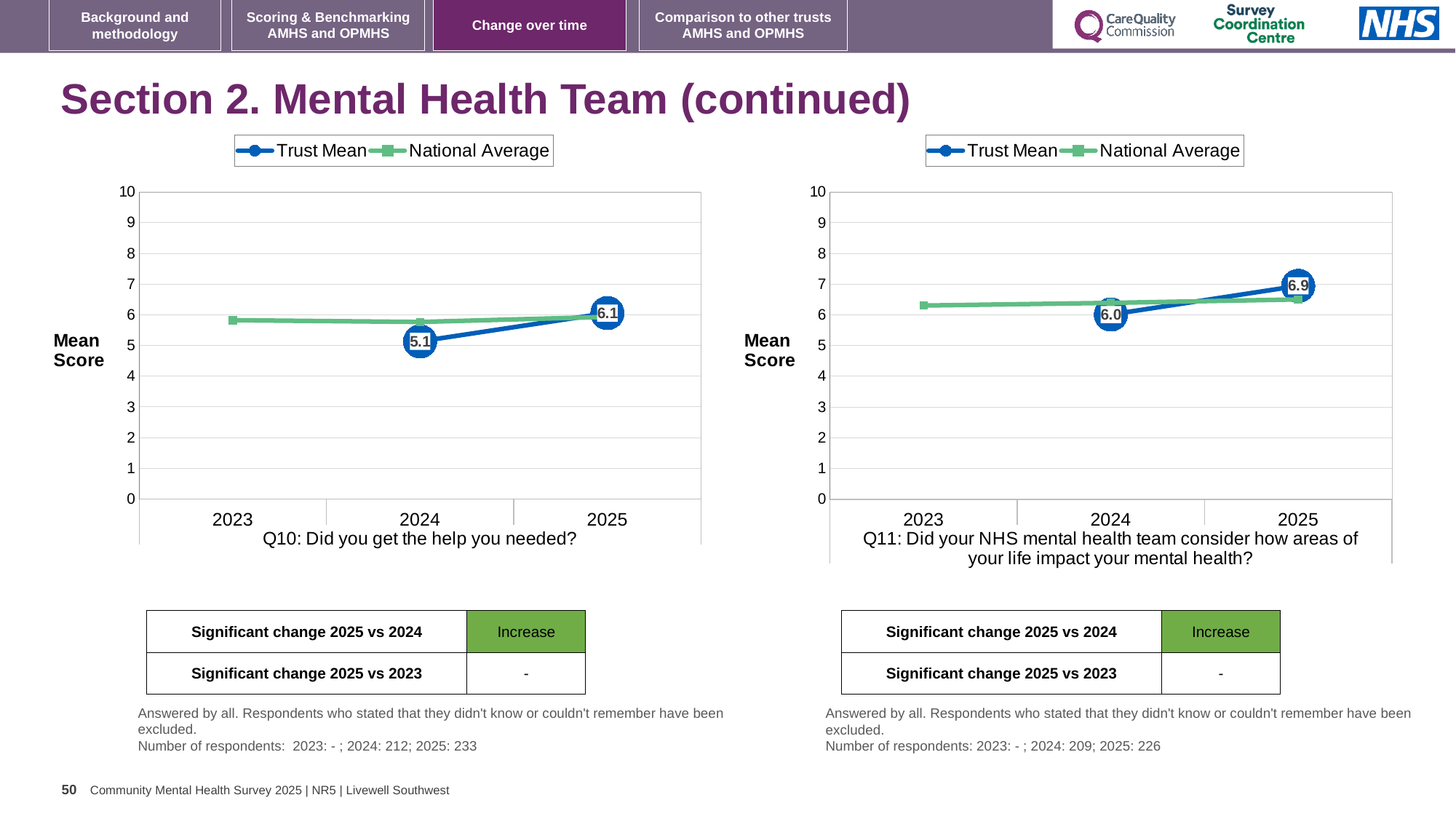
In the Q11 chart, what is the difference between the Trust Mean in 2025 and in 2024? 0.9 In the Q10 chart, what is the Trust Mean score for 2024? 5.1 In the Q11 chart, what is the Trust Mean score for 2024? 6.0 What kind of chart is the Q10 chart? line chart How many years are shown on the x axis of the Q10 chart? 3 In the Q11 chart, does the Trust Mean rise or fall from 2024 to 2025? rise How many series does the legend of the Q11 chart list? 2 In the Q11 chart, what is the Trust Mean score for 2025? 6.9 In the Q10 chart, which is larger in 2025: the Trust Mean or the National Average? Trust Mean In the Q11 chart, is the National Average for 2023 greater or less than 6? greater In the Q10 chart, what is the Trust Mean score for 2025? 6.1 In the Q10 chart, by how much did the Trust Mean change from 2024 to 2025? 1.0